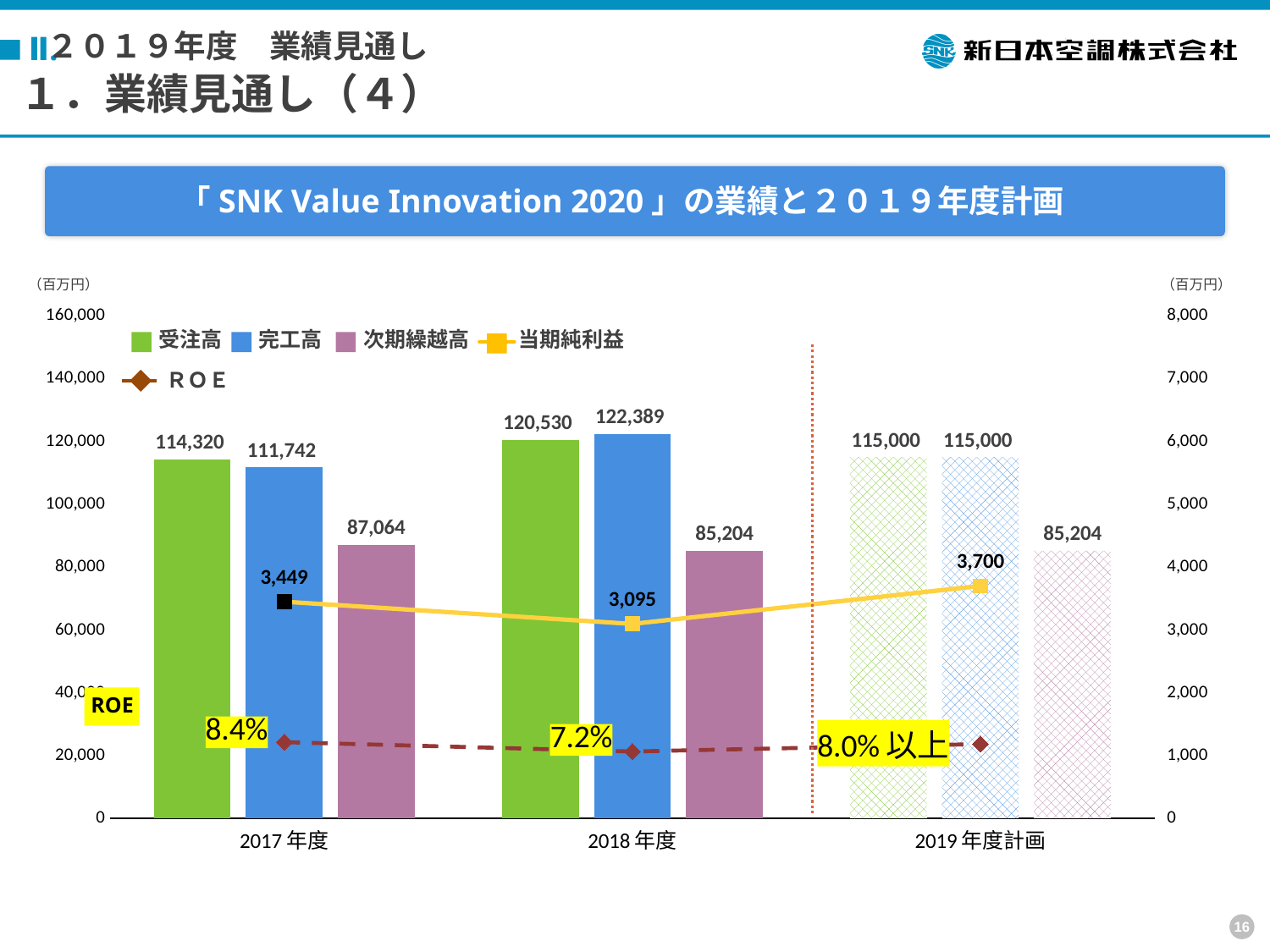
What is the ROE value shown for 2018年度? 7.2% How many series does the legend list? 5 Which year has the lowest 当期純利益? 2018年度 What is the 当期純利益 value for 2019年度計画? 3,700 Does the 当期純利益 line rise or fall from 2018年度 to 2019年度計画? rise What is the 受注高 value for 2017年度? 114,320 What is the 完工高 value for 2018年度? 122,389 What is the 次期繰越高 value for 2017年度? 87,064 What is the difference between 受注高 in 2018年度 and 2017年度? 6,210 Which is larger in 2017年度, 受注高 or 完工高? 受注高 How many fiscal-year categories are shown on the x axis? 3 Which year has the highest 完工高? 2018年度